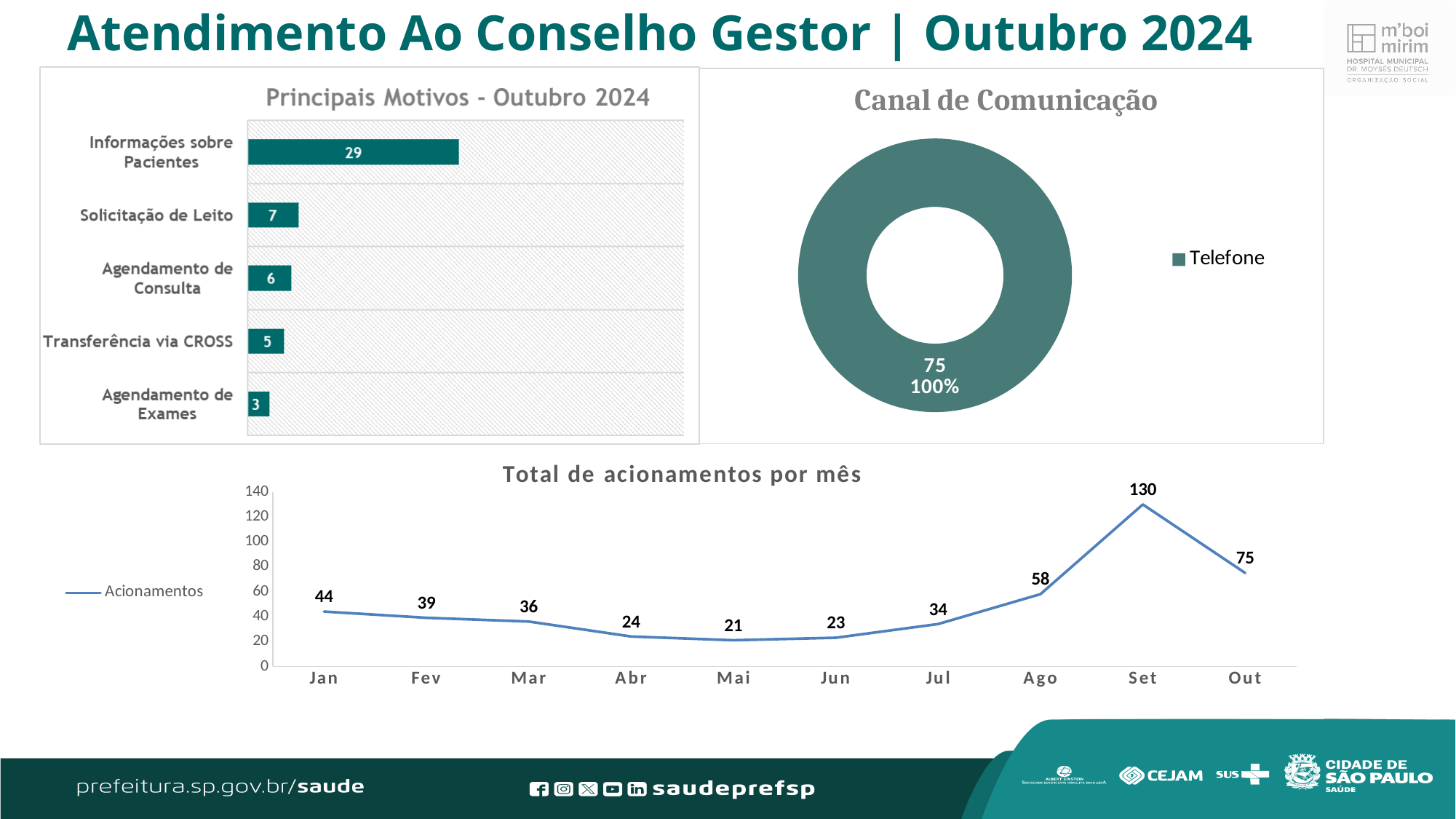
In the 'Principais Motivos - Outubro 2024' chart, which category has the highest value? Informações sobre Pacientes What kind of chart is 'Principais Motivos - Outubro 2024'? Bar chart In the 'Principais Motivos - Outubro 2024' chart, what is the value for Solicitação de Leito? 7 In the 'Principais Motivos - Outubro 2024' chart, what is the difference between Informações sobre Pacientes and Transferência via CROSS? 24 In the 'Total de acionamentos por mês' chart, what is the difference between Set and Out? 55 In the 'Total de acionamentos por mês' chart, which month has the lowest value? Mai In the 'Principais Motivos - Outubro 2024' chart, which category has the lowest value? Agendamento de Exames In the 'Canal de Comunicação' chart, what is the value shown for Telefone? 75 In the 'Principais Motivos - Outubro 2024' chart, how many categories are shown? 5 In the 'Canal de Comunicação' chart, what share does Telefone have? 100% In the 'Total de acionamentos por mês' chart, how many months are plotted? 10 In the 'Total de acionamentos por mês' chart, what is the value for Set? 130